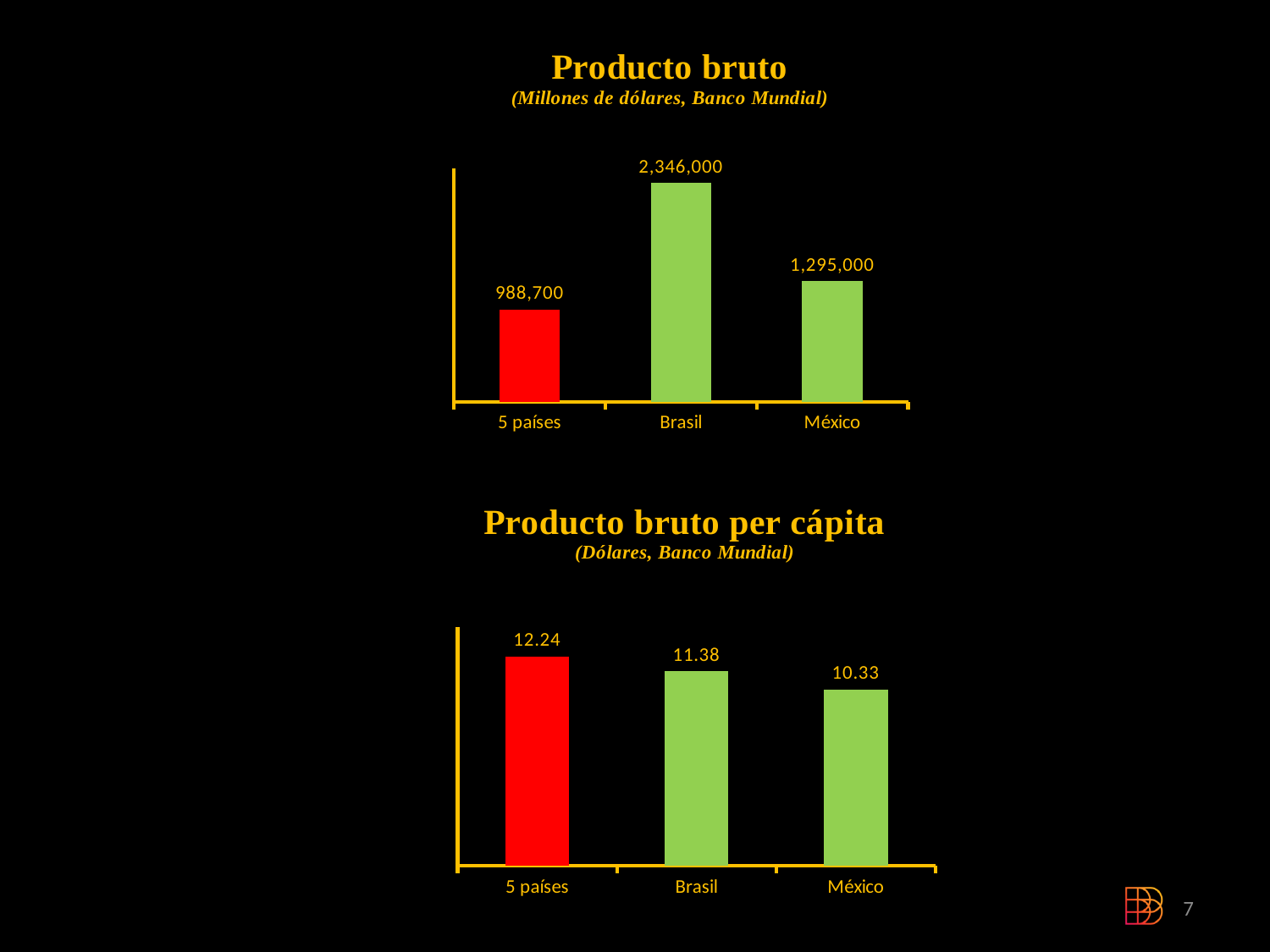
In the 'Producto bruto' chart, what is the value for Brasil? 2,346,000 What kind of chart is the 'Producto bruto per cápita' chart? bar chart In the 'Producto bruto per cápita' chart, what is the difference between the values for 5 países and Brasil? 0.86 In the 'Producto bruto' chart, what is the value for 5 países? 988,700 In the 'Producto bruto per cápita' chart, what is the value for 5 países? 12.24 How many categories are shown in the 'Producto bruto' chart? 3 In the 'Producto bruto per cápita' chart, which category has the highest value? 5 países In the 'Producto bruto' chart, which category has the highest value? Brasil In the 'Producto bruto per cápita' chart, do the values rise or fall from left to right along the x axis? fall In the 'Producto bruto per cápita' chart, what is the value for México? 10.33 In the 'Producto bruto' chart, which category has the lowest value? 5 países In the 'Producto bruto' chart, what is the difference between the values for Brasil and México? 1,051,000